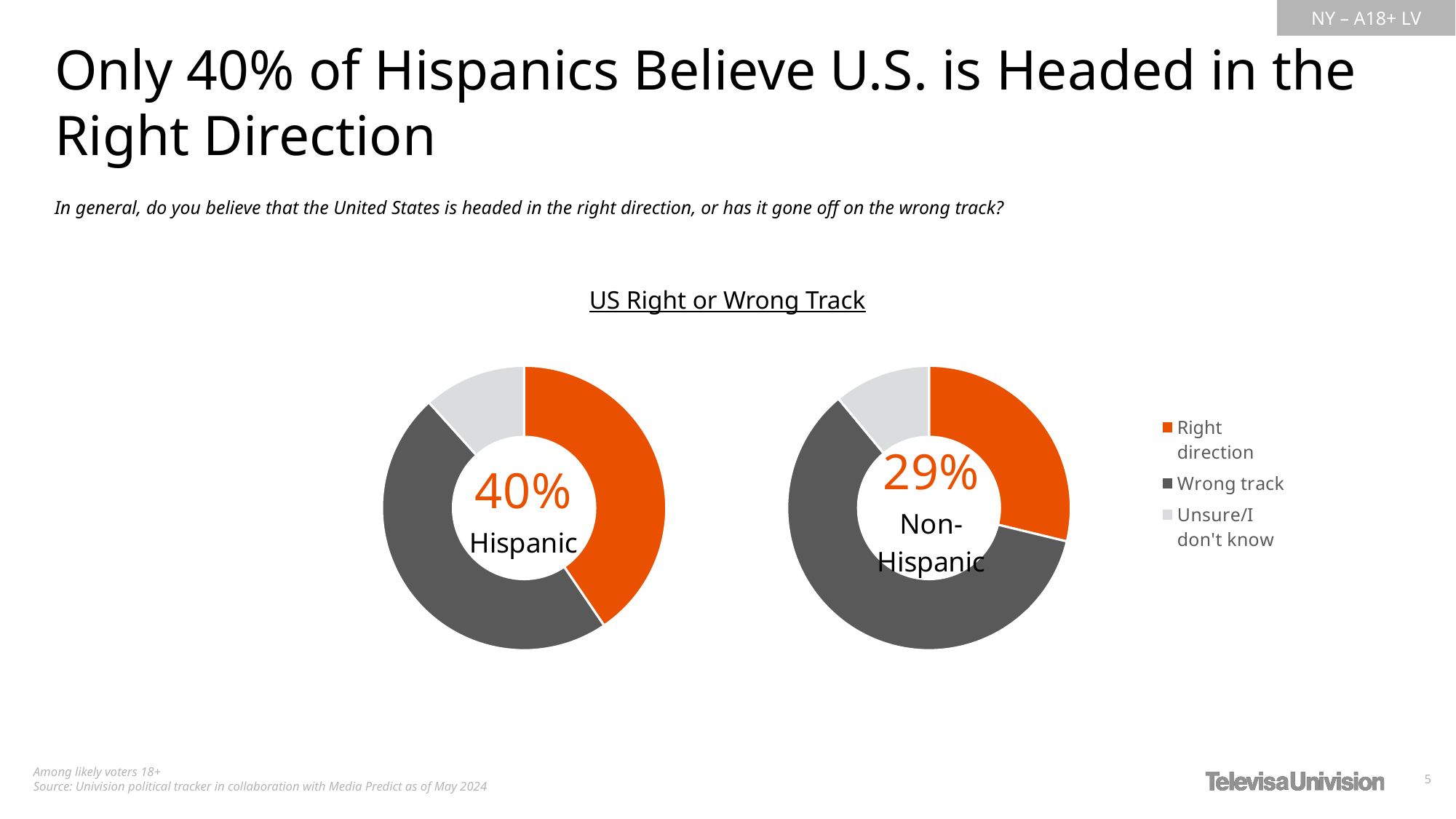
What is the title shown above the two donut charts? US Right or Wrong Track In the Non-Hispanic donut chart, which response category has the smallest slice? Unsure/I don't know How many slices does the Hispanic donut chart have? 3 What kind of chart is used to show the US Right or Wrong Track results? Donut (pie) chart In the Non-Hispanic donut chart, what share of respondents said the U.S. is headed in the right direction? 29% In the Non-Hispanic donut chart, which response category has the largest slice? Wrong track Which group has the larger 'Right direction' share, Hispanic or Non-Hispanic? Hispanic Which colour represents 'Right direction' in the donut charts? Orange In the Hispanic donut chart, what share of respondents said the U.S. is headed in the right direction? 40% In the Hispanic donut chart, which response category has the largest slice? Wrong track How many categories does the legend list for the US Right or Wrong Track charts? 3 By how many percentage points does the Hispanic 'Right direction' share exceed the Non-Hispanic 'Right direction' share? 11 percentage points